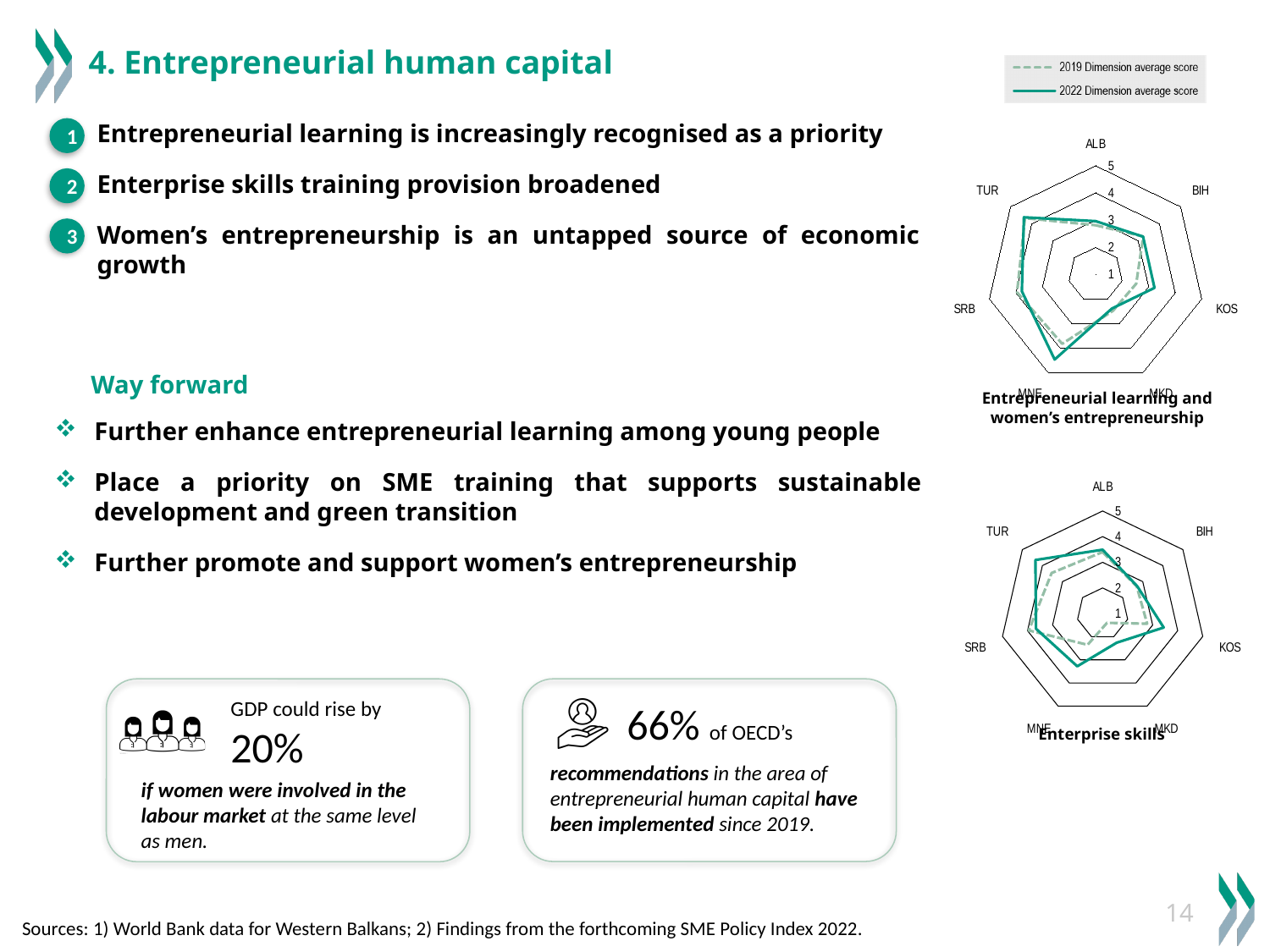
In the 'Enterprise skills' chart, is the 2022 Dimension average score for TUR greater or less than 3? greater What kind of chart is the 'Enterprise skills' chart? Radar chart How many series does the legend list for the radar charts? 2 In the 'Entrepreneurial learning and women's entrepreneurship' chart, is the 2022 Dimension average score for ALB greater or less than 5? less In the 'Entrepreneurial learning and women's entrepreneurship' chart, is the 2022 Dimension average score for MNE greater or less than 3? greater Which series is drawn with a dashed line in the radar charts? 2019 Dimension average score What is the highest value shown on the axis scale of the radar charts? 5 How many economies are plotted on the 'Enterprise skills' radar chart? 7 How many economies (categories) are plotted on the 'Entrepreneurial learning and women's entrepreneurship' radar chart? 7